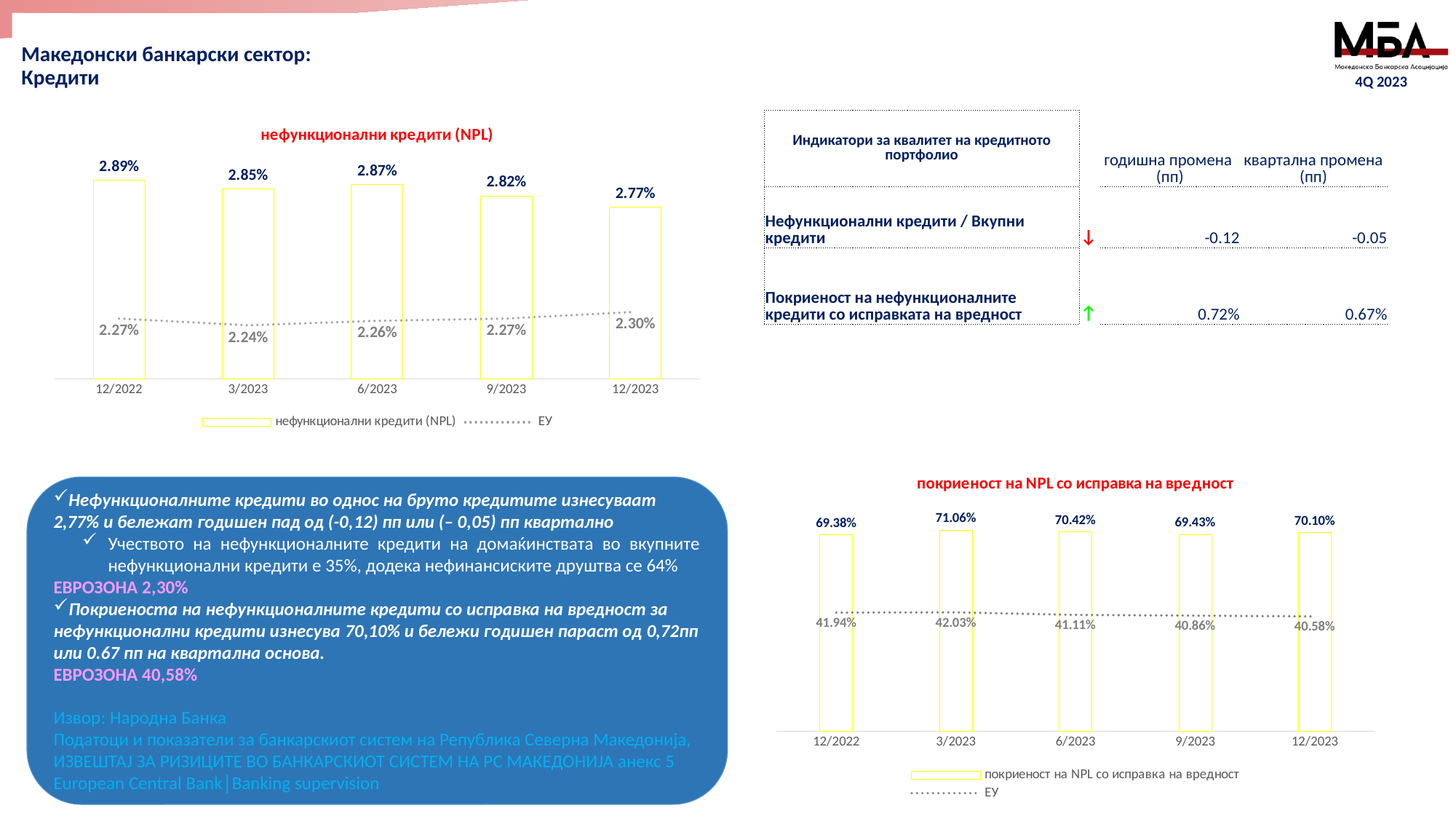
In the chart titled "нефункционални кредити (NPL)", what is the ЕУ value for 3/2023? 2.24% What type of chart is the chart titled "покриеност на NPL со исправка на вредност"? bar chart with a line In the chart titled "покриеност на NPL со исправка на вредност", what is the bar value for 3/2023? 71.06% In the chart titled "нефункционални кредити (NPL)", what is the NPL value for 12/2023? 2.77% In the chart titled "нефункционални кредити (NPL)", how many series does the legend list? 2 In the chart titled "нефункционални кредити (NPL)", which period has the highest NPL bar? 12/2022 In the chart titled "нефункционални кредити (NPL)", what is the difference between the NPL bar and the ЕУ value for 12/2023? 0.47% In the chart titled "нефункционални кредити (NPL)", do the NPL bar values generally rise or fall from 12/2022 to 12/2023? fall In the chart titled "покриеност на NPL со исправка на вредност", is the bar value for 6/2023 larger or smaller than the bar value for 9/2023? larger In the chart titled "покриеност на NPL со исправка на вредност", how many periods are shown on the x axis? 5 In the chart titled "покриеност на NPL со исправка на вредност", what is the ЕУ value for 12/2023? 40.58% In the chart titled "покриеност на NPL со исправка на вредност", which period has the lowest bar value? 12/2022